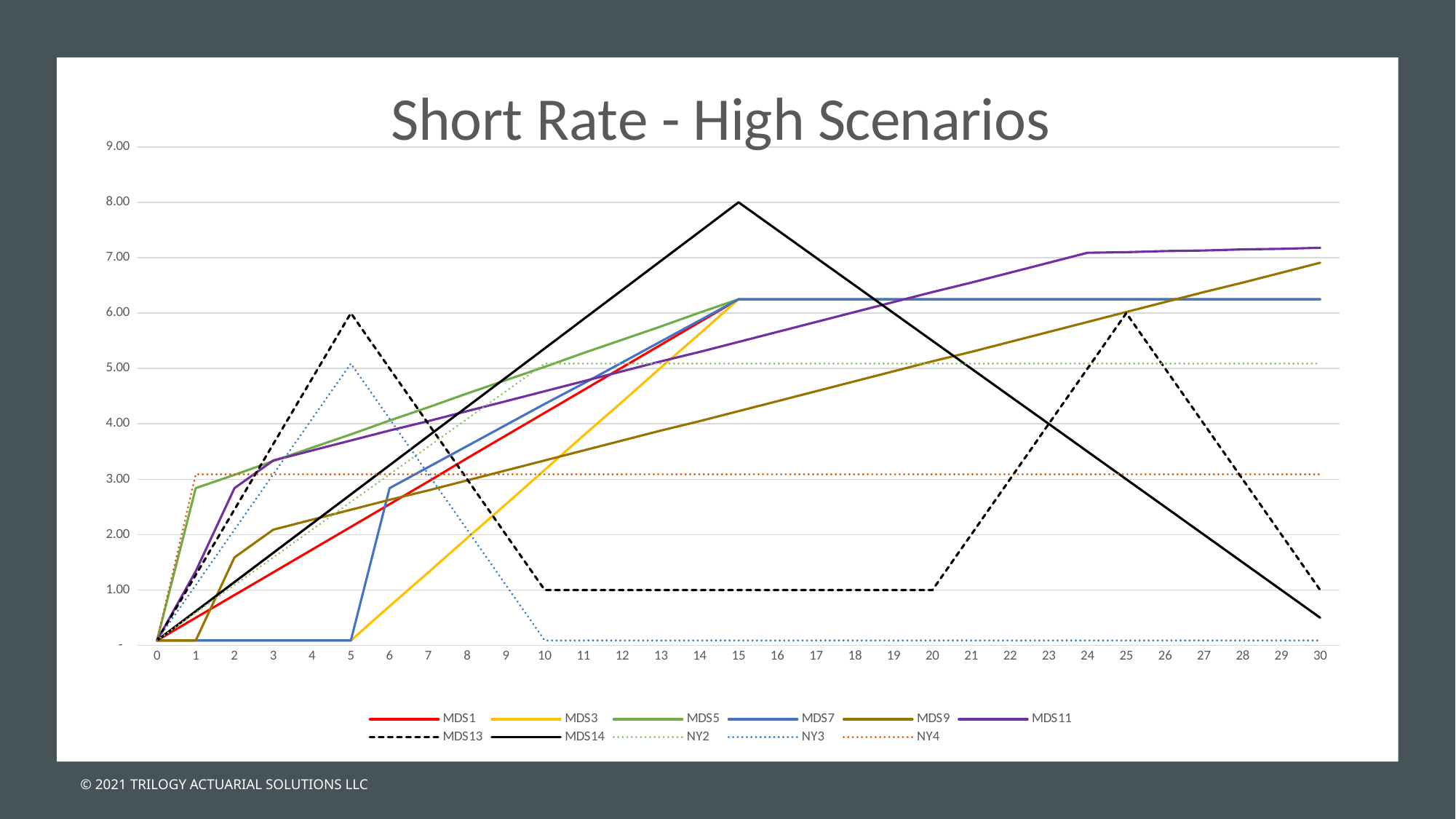
What is the value of the MDS13 series at x = 15? 1.00 Is the value of MDS14 at x = 30 greater or less than 1.00? less Does the MDS11 series generally rise or fall from x = 0 to x = 30? rise Is the value of MDS11 at x = 30 greater or less than 7.00? greater What value does the MDS13 series reach at x = 5? 6.00 What is the peak value of the MDS14 series, reached at x = 15? 8.00 What kind of chart is shown on the slide? line chart At x = 15, which series has the larger value, MDS14 or MDS13? MDS14 Which series reaches the highest value anywhere on the chart? MDS14 How many series does the legend list? 11 How many points are on the x axis (from 0 to 30)? 31 What is the title of the chart? Short Rate - High Scenarios